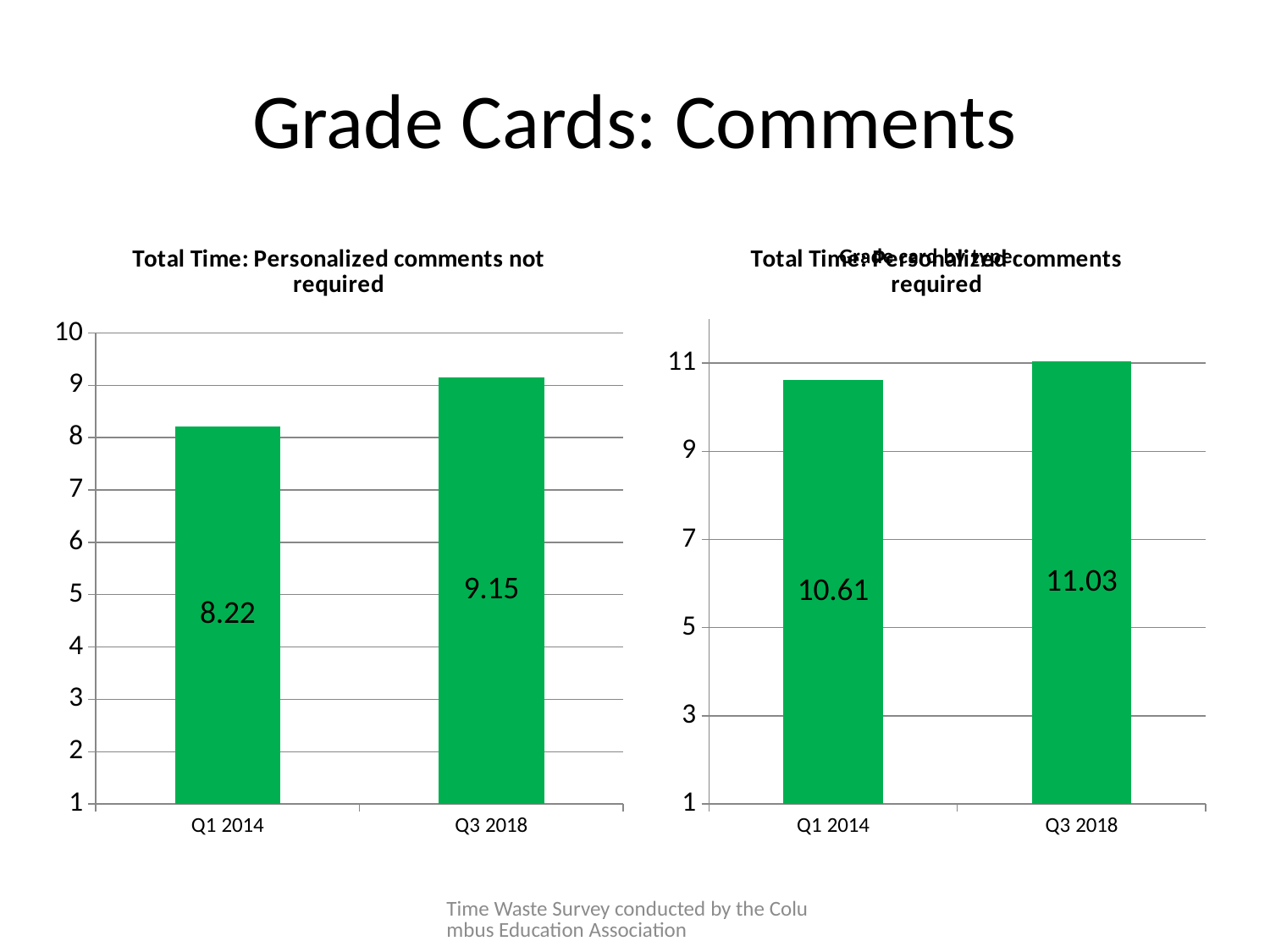
In the left chart (Total Time: Personalized comments not required), which category has the highest value? Q3 2018 In the left chart (Total Time: Personalized comments not required), what is the difference between the Q3 2018 and Q1 2014 values? 0.93 In the left chart (Total Time: Personalized comments not required), what is the value for Q1 2014? 8.22 What kind of chart is the right chart (Total Time: Personalized comments required)? Bar chart In the right chart (Total Time: Personalized comments required), what is the value for Q1 2014? 10.61 In the right chart (Total Time: Personalized comments required), which category has the lowest value? Q1 2014 In the left chart (Total Time: Personalized comments not required), what is the value for Q3 2018? 9.15 In the right chart (Total Time: Personalized comments required), what is the value for Q3 2018? 11.03 In the left chart (Total Time: Personalized comments not required), do the values rise or fall from Q1 2014 to Q3 2018? Rise How many categories are shown in the left chart (Total Time: Personalized comments not required)? 2 In the right chart (Total Time: Personalized comments required), what is the difference between the Q3 2018 and Q1 2014 values? 0.42 In the right chart (Total Time: Personalized comments required), which is larger, the value for Q1 2014 or Q3 2018? Q3 2018